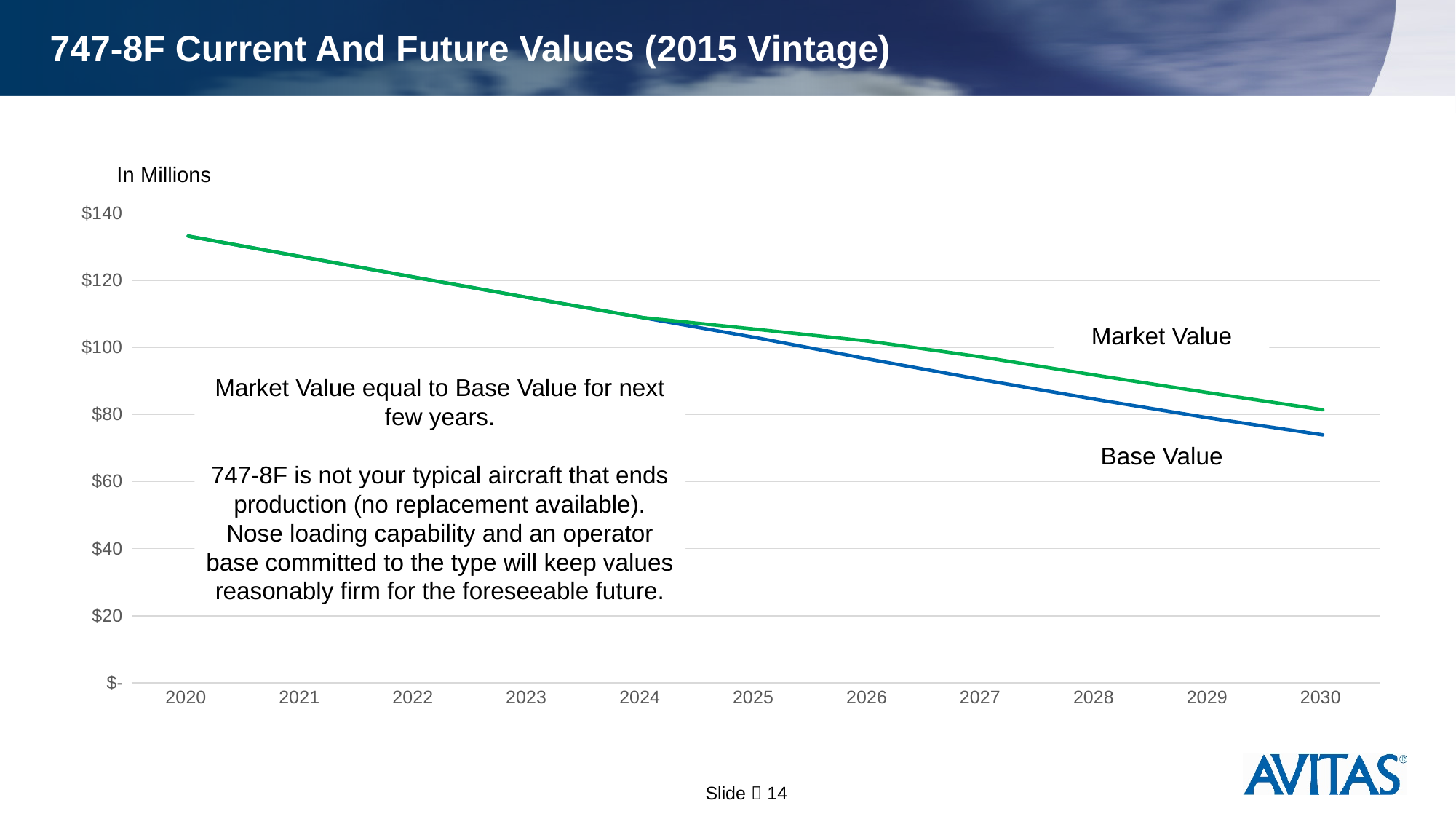
Which year has the highest Market Value on the chart? 2020 What kind of chart is shown on the slide? line chart What is the title of the slide's chart? 747-8F Current And Future Values (2015 Vintage) Is the Base Value in 2030 greater or less than $80? less How many lines are plotted on the chart? 2 In what units are the values on the chart expressed? In Millions Is the Market Value in 2020 greater or less than $120? greater Do the Market Value and Base Value lines rise or fall from 2020 to 2030? fall How many years are shown along the x axis of the chart? 11 In 2030, which is higher, the Market Value or the Base Value? Market Value Is the Market Value in 2024 greater or less than $100? greater